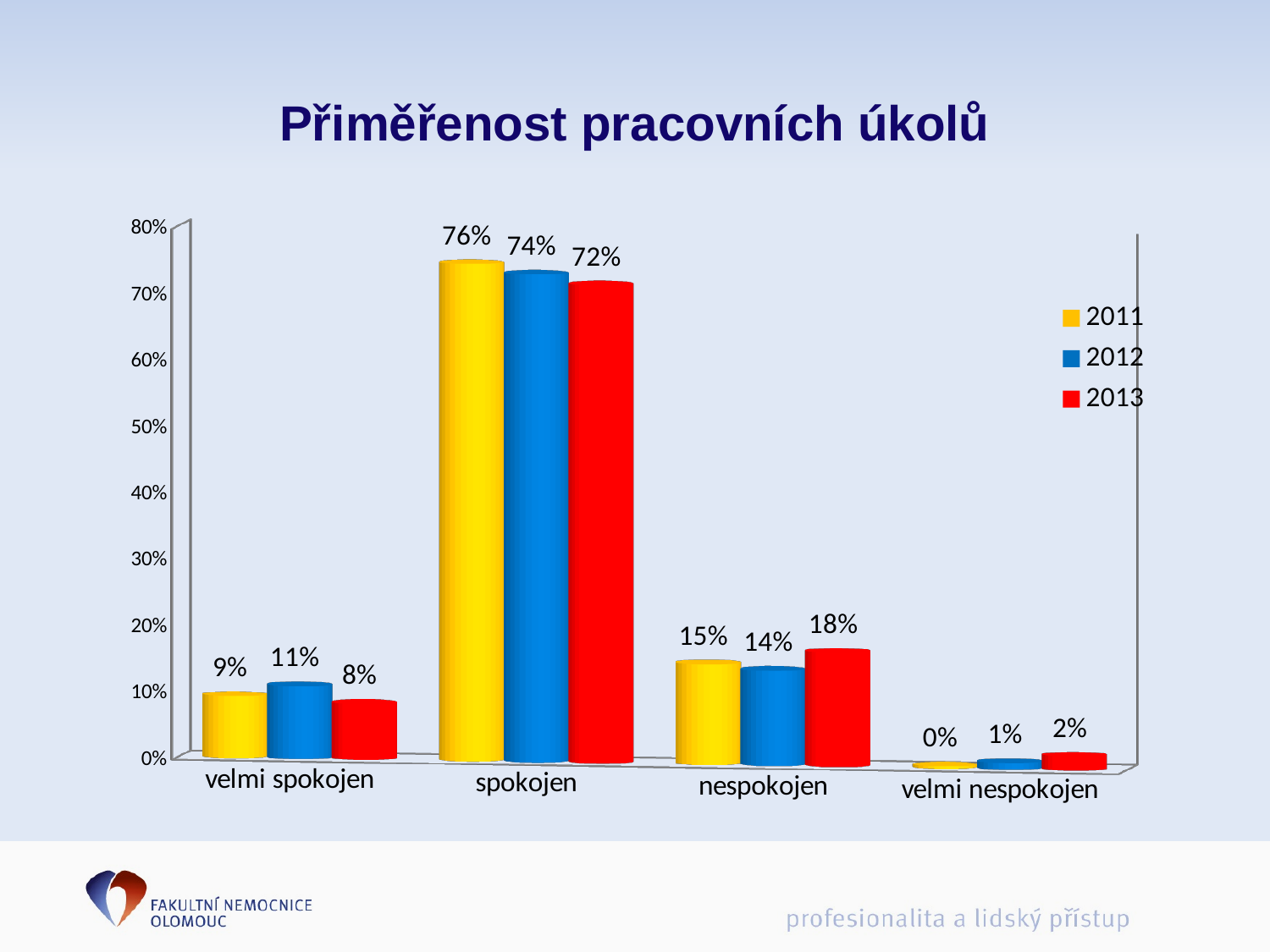
What is the difference between the 2011 and 2013 values in the 'spokojen' category? 4% What is the value for 2011 in the 'velmi nespokojen' category? 0% What is the value for 2012 in the 'velmi spokojen' category? 11% What is the title of the chart? Přiměřenost pracovních úkolů How many categories are shown on the x axis? 4 What is the value for 2013 in the 'nespokojen' category? 18% How many series does the legend list? 3 What is the value for 2011 in the 'spokojen' category? 76% Which category has the lowest value for 2012? velmi nespokojen What kind of chart is shown on the slide? bar chart Which is larger in the 'nespokojen' category: the value for 2011 or the value for 2013? 2013 Which category has the highest value for 2013? spokojen